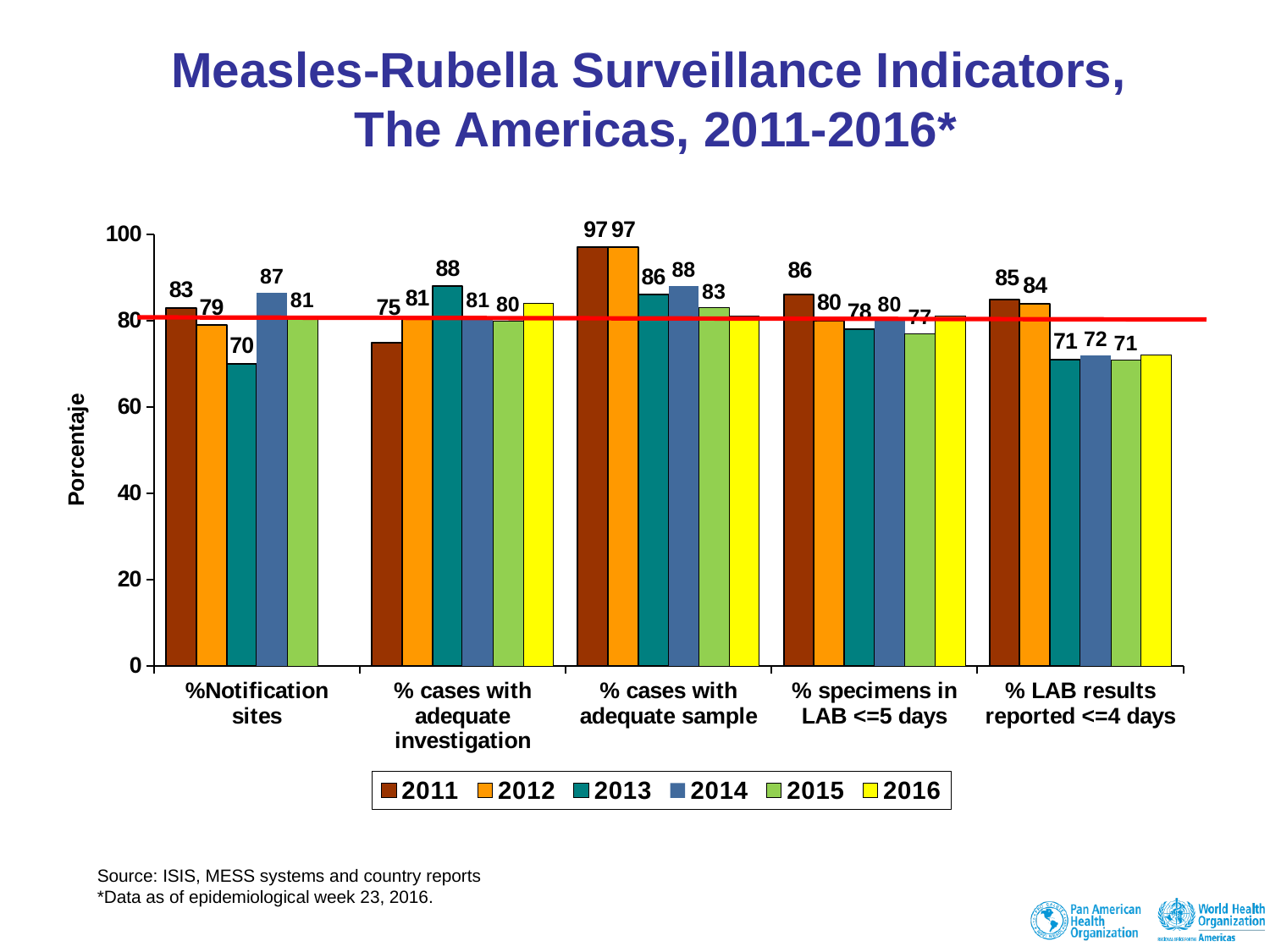
In the %Notification sites category, what is the difference between the 2014 value and the 2013 value? 17 In the % specimens in LAB <=5 days category, which year has the larger value, 2011 or 2012? 2011 How many surveillance indicator categories are shown along the x axis? 5 Is the value for 2016 in the % LAB results reported <=4 days category greater or less than 80? less What is the label on the y axis of the chart? Porcentaje What kind of chart is shown on the slide? bar chart In the % cases with adequate investigation category, which year has the highest value? 2013 What is the value for 2013 in the %Notification sites category? 70 What is the value for 2015 in the % specimens in LAB <=5 days category? 77 In the %Notification sites category, which year has the lowest value? 2013 What is the value for 2011 in the % cases with adequate sample category? 97 How many years (series) does the legend list? 6